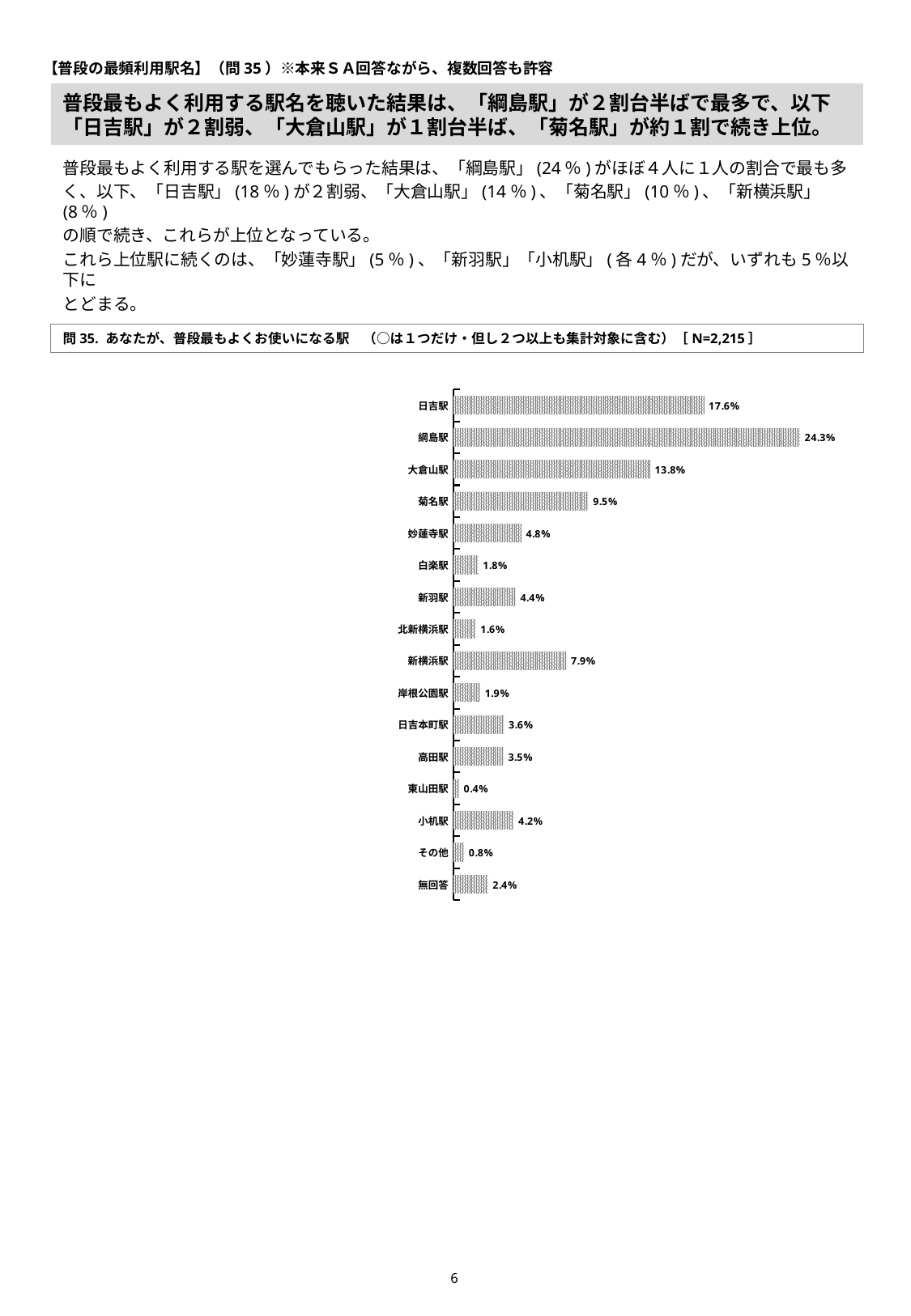
Which category has the lowest value? 東山田駅 What kind of chart is shown on the slide? Bar chart What is the sample size (N) shown in the question box above the chart? N=2,215 What is the value for 綱島駅? 24.3% What is the difference between the values for 綱島駅 and 日吉駅? 6.7% What is the value for 東山田駅? 0.4% How many categories are shown in the chart? 16 Which is larger, the value for 妙蓮寺駅 or the value for 新羽駅? 妙蓮寺駅 What is the value for 新横浜駅? 7.9% Which station has the highest value? 綱島駅 What is the difference between the values for 大倉山駅 and 菊名駅? 4.3% What is the value for 日吉駅? 17.6%